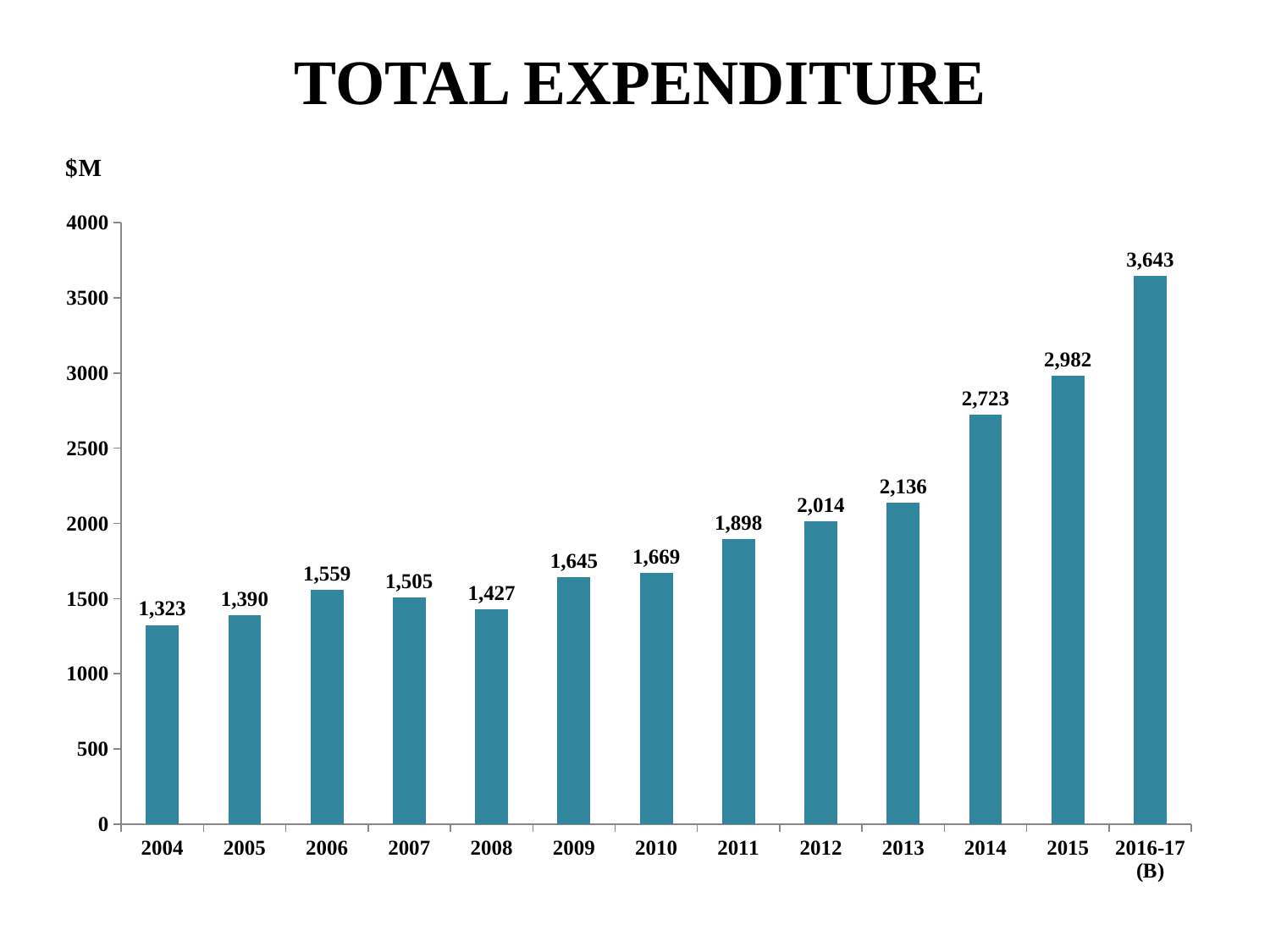
How many years are shown on the x axis? 13 Which year has the larger total expenditure, 2007 or 2008? 2007 Which year has the highest total expenditure? 2016-17 (B) What is the total expenditure for 2010? 1,669 Do the values generally rise or fall from 2008 to 2016-17 (B)? Rise What is the total expenditure for 2016-17 (B)? 3,643 What is the difference in total expenditure between 2015 and 2014? 259 What unit is shown above the y axis? $M What kind of chart is shown on the slide? Bar chart Is the value for 2013 greater or less than 2000? greater What is the total expenditure for 2008? 1,427 Which year has the lowest total expenditure? 2004